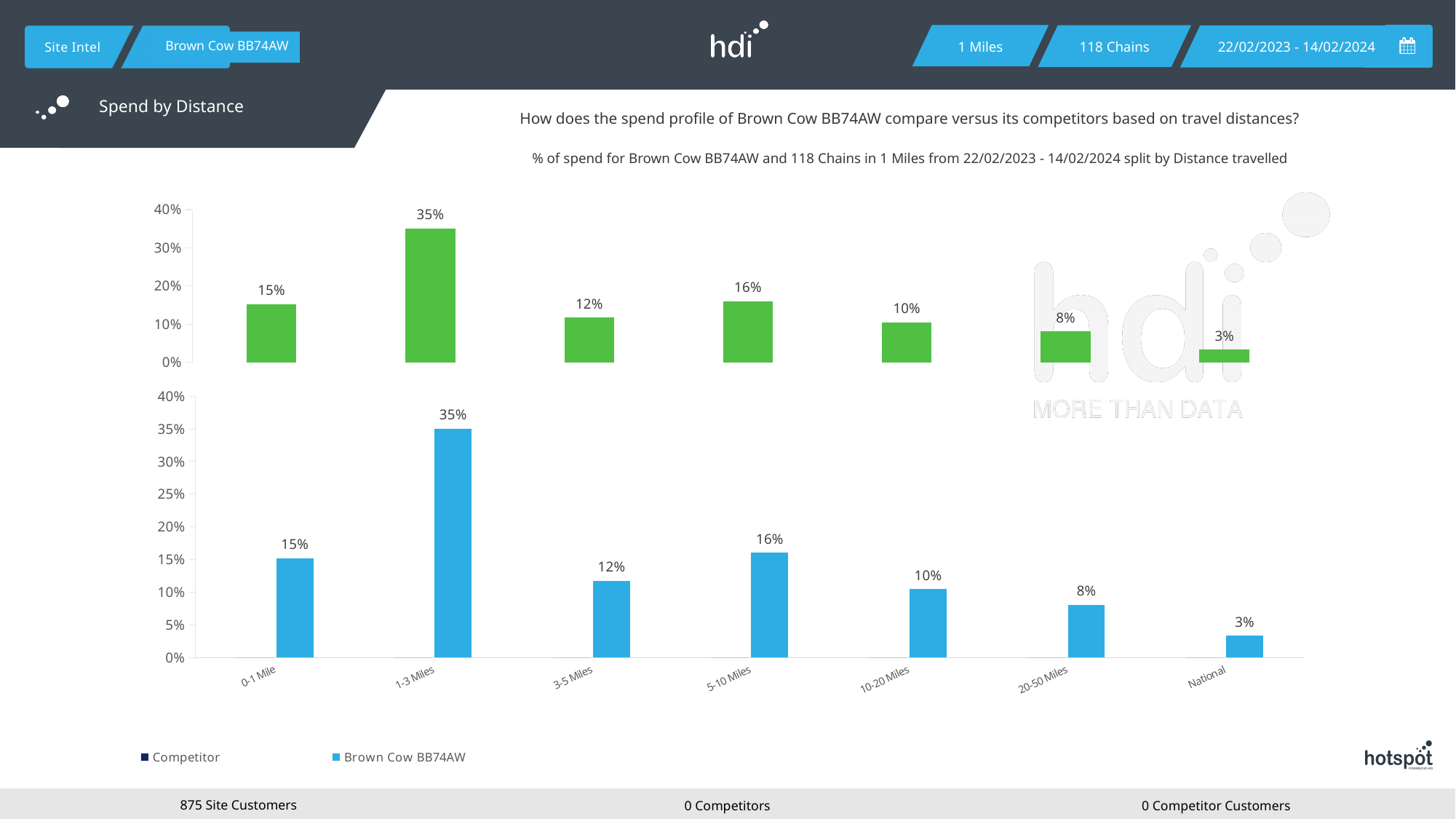
In the bottom chart, what is the difference between the values for 1-3 Miles and 0-1 Mile? 20% In the bottom chart, what is the value for 1-3 Miles? 35% In the bottom chart, what is the value for 5-10 Miles? 16% How many series does the legend at the bottom of the slide list? 2 In the bottom chart, which distance band has the lowest value? National In the bottom chart, which is larger, the value for 3-5 Miles or the value for 10-20 Miles? 3-5 Miles In the top chart, what is the highest value labelled on a bar? 35% In the bottom chart, how many distance bands are shown on the x axis? 7 In the bottom chart, what is the value for National? 3% In the bottom chart, which distance band has the highest value? 1-3 Miles In the bottom chart, is the value for 20-50 Miles greater or less than 10%? less What kind of chart is the bottom chart? bar chart